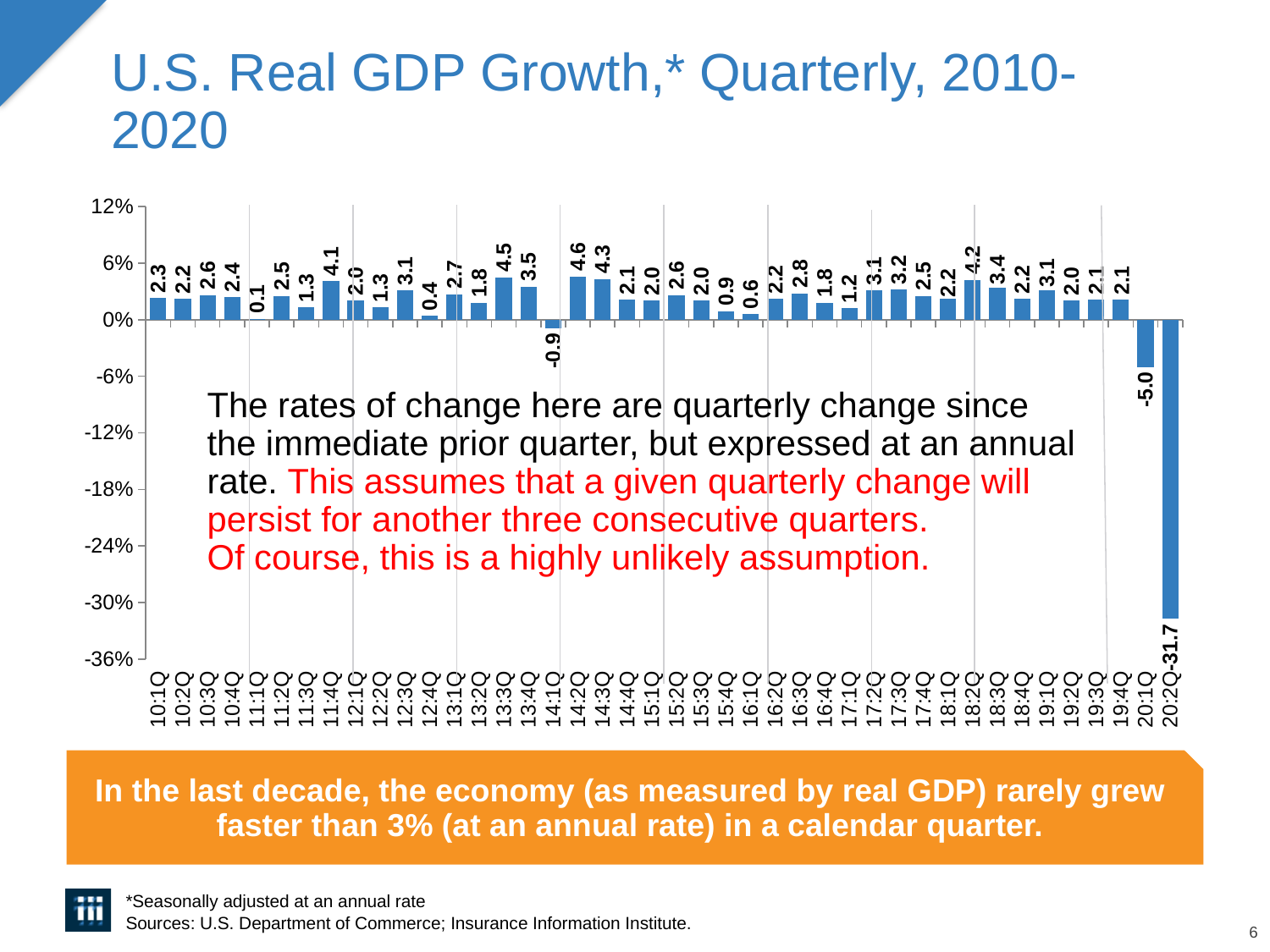
Which quarter has the highest real GDP growth value? 14:2Q How many quarters are plotted on the chart? 42 What kind of chart is shown on the slide? Bar chart Which quarter has the lowest real GDP growth value? 20:2Q Is the value for 20:2Q greater or less than -30%? less What is the difference between the values for 20:1Q and 20:2Q? 26.7 What is the title of the chart? U.S. Real GDP Growth,* Quarterly, 2010-2020 What is the difference between the values for 14:2Q and 14:3Q? 0.3 What is the real GDP growth value shown for 14:1Q? -0.9 What is the real GDP growth value shown for 18:2Q? 4.2 Which is larger, the value for 13:3Q or the value for 13:4Q? 13:3Q What is the real GDP growth value shown for 20:2Q? -31.7